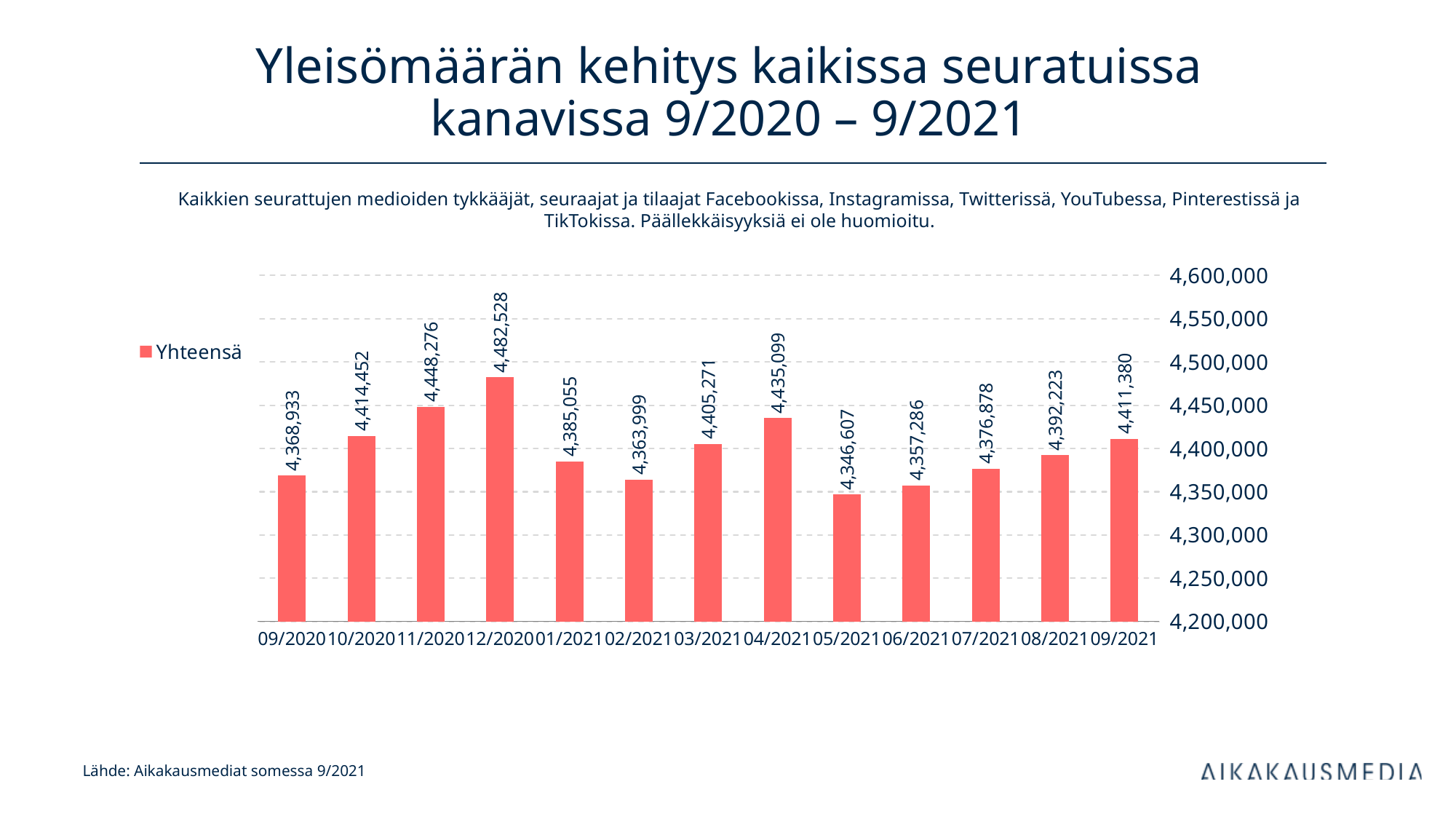
What is the value for 09/2021? 4,411,380 How many months are shown on the x axis? 13 Which month has the lowest value? 05/2021 What is the value for 05/2021? 4,346,607 What is the value for 12/2020? 4,482,528 What is the difference between the values for 12/2020 and 05/2021? 135,921 What kind of chart is shown on the slide? bar chart Which month has the highest value? 12/2020 Is the value for 11/2020 greater or less than 4,400,000? greater What is the difference between the values for 09/2021 and 09/2020? 42,447 How many series does the legend list? 1 Which is larger, the value for 04/2021 or the value for 03/2021? 04/2021